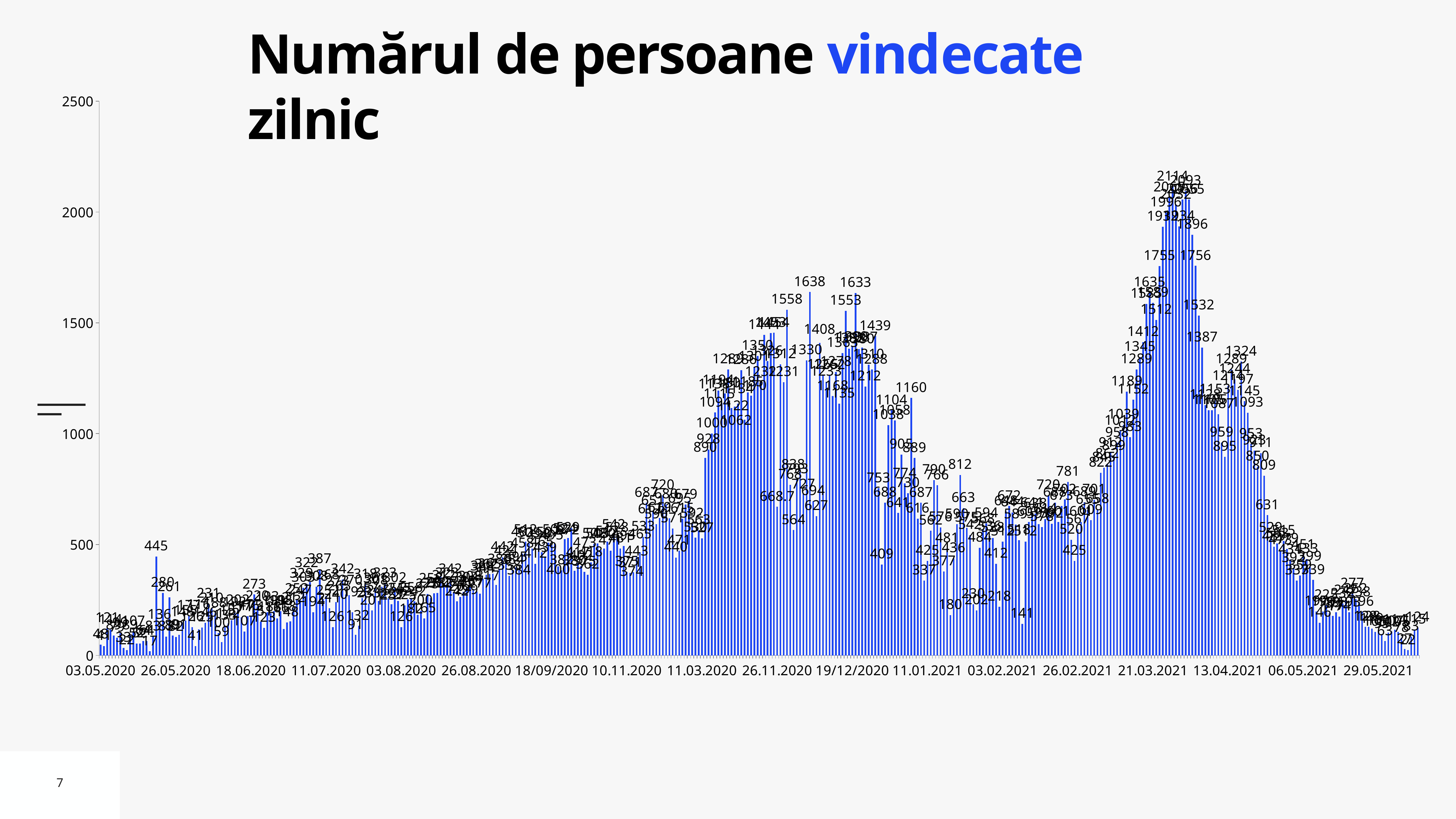
What is the difference between the peak labeled 2114 and the peak labeled 1638? 476 What is the highest value shown on the vertical axis? 2500 What kind of chart is shown on the slide? bar chart What is the last date label on the horizontal axis? 29.05.2021 Do the values rise or fall between 13.04.2021 and 29.05.2021? fall What is the title of the chart? Numărul de persoane vindecate zilnic What is the first date label on the horizontal axis? 03.05.2020 How many date labels are printed along the horizontal axis? 18 Which is larger, the peak labeled 1638 or the peak labeled 2114? 2114 Is the tallest bar on the chart greater or less than 2000? greater Is the tallest bar near 26.05.2020 (labeled 445) greater or less than 500? less What is the highest data label shown on the chart? 2114